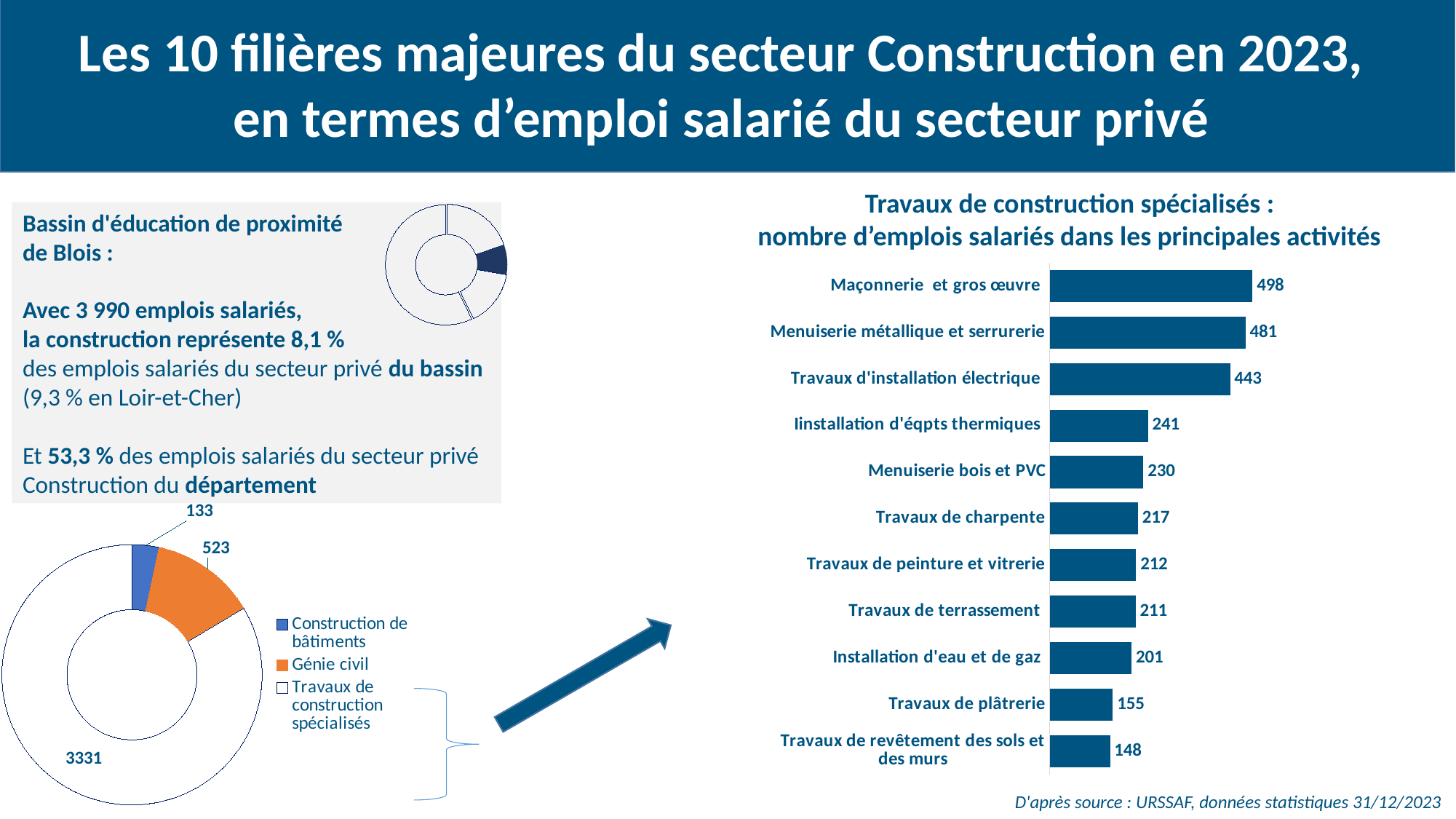
In the doughnut chart at the bottom left, what is the value for Génie civil? 523 In the bar chart on the right, what is the value for Travaux de plâtrerie? 155 In the bar chart on the right, which activity has the lowest number of salaried jobs? Travaux de revêtement des sols et des murs In the bar chart on the right, which is larger: Travaux d'installation électrique or Installation d'éqpts thermiques? Travaux d'installation électrique In the bar chart on the right, which activity has the highest number of salaried jobs? Maçonnerie et gros œuvre In the bar chart on the right, what is the difference between Maçonnerie et gros œuvre and Menuiserie métallique et serrurerie? 17 In the bar chart on the right, how many salaried jobs are shown for Maçonnerie et gros œuvre? 498 How many activities are listed in the bar chart on the right? 11 In the doughnut chart at the bottom left, what is the value for Construction de bâtiments? 133 How many categories does the legend of the doughnut chart at the bottom left list? 3 In the doughnut chart at the bottom left, which category has the largest value? Travaux de construction spécialisés What type of chart is used on the right side of the slide to show jobs by activity? Bar chart